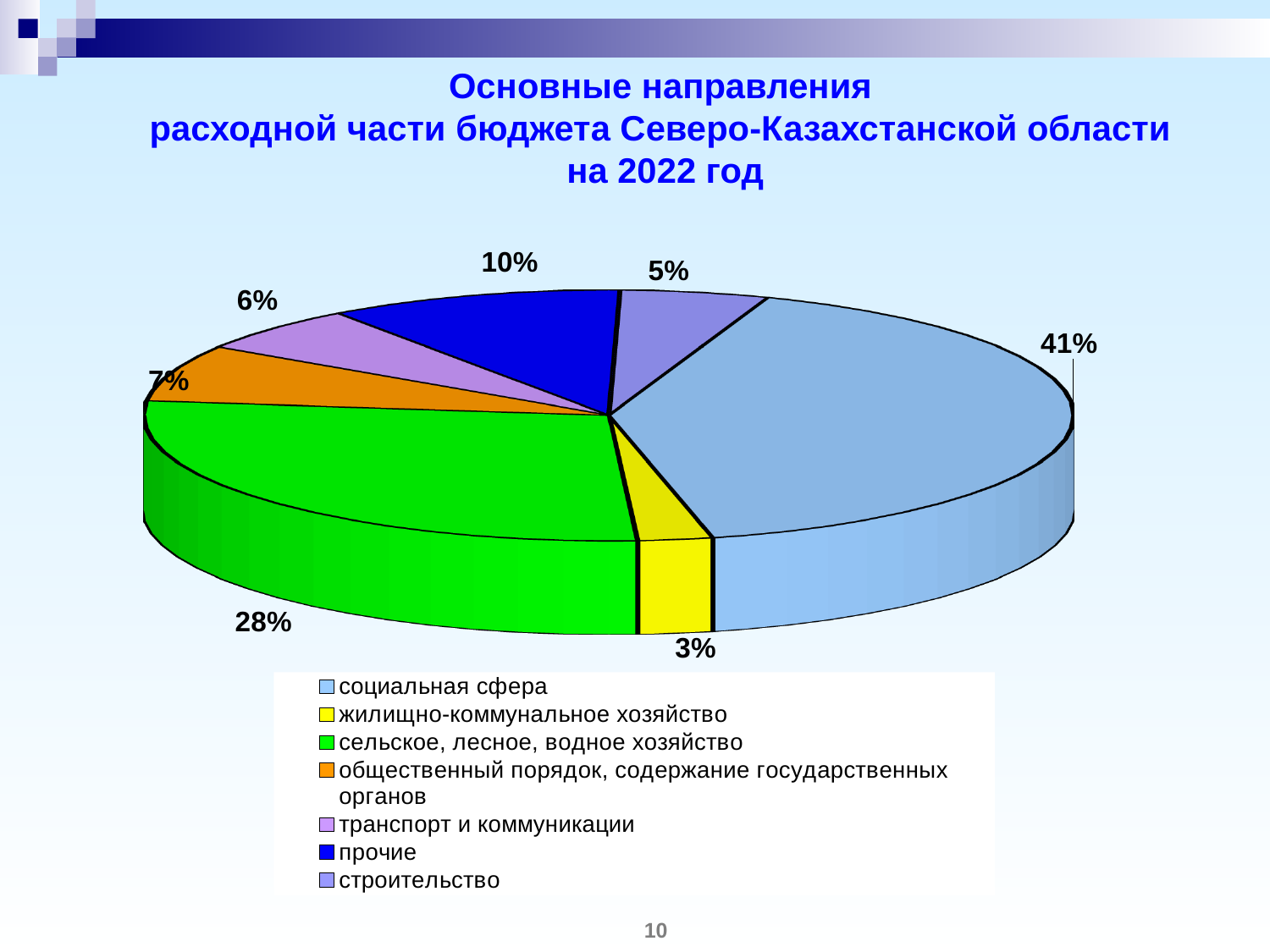
What share of the budget expenditure goes to строительство? 5% What share of the budget expenditure goes to социальная сфера? 41% Which year does the chart title refer to? 2022 What is the difference in percentage points between социальная сфера and сельское, лесное, водное хозяйство? 13 Which is larger, the share for транспорт и коммуникации or the share for общественный порядок, содержание государственных органов? общественный порядок, содержание государственных органов What share of the budget expenditure goes to жилищно-коммунальное хозяйство? 3% How many categories does the legend list? 7 Which category has the largest share of the pie? социальная сфера What kind of chart is shown on the slide? pie chart Which category has the smallest share of the pie? жилищно-коммунальное хозяйство